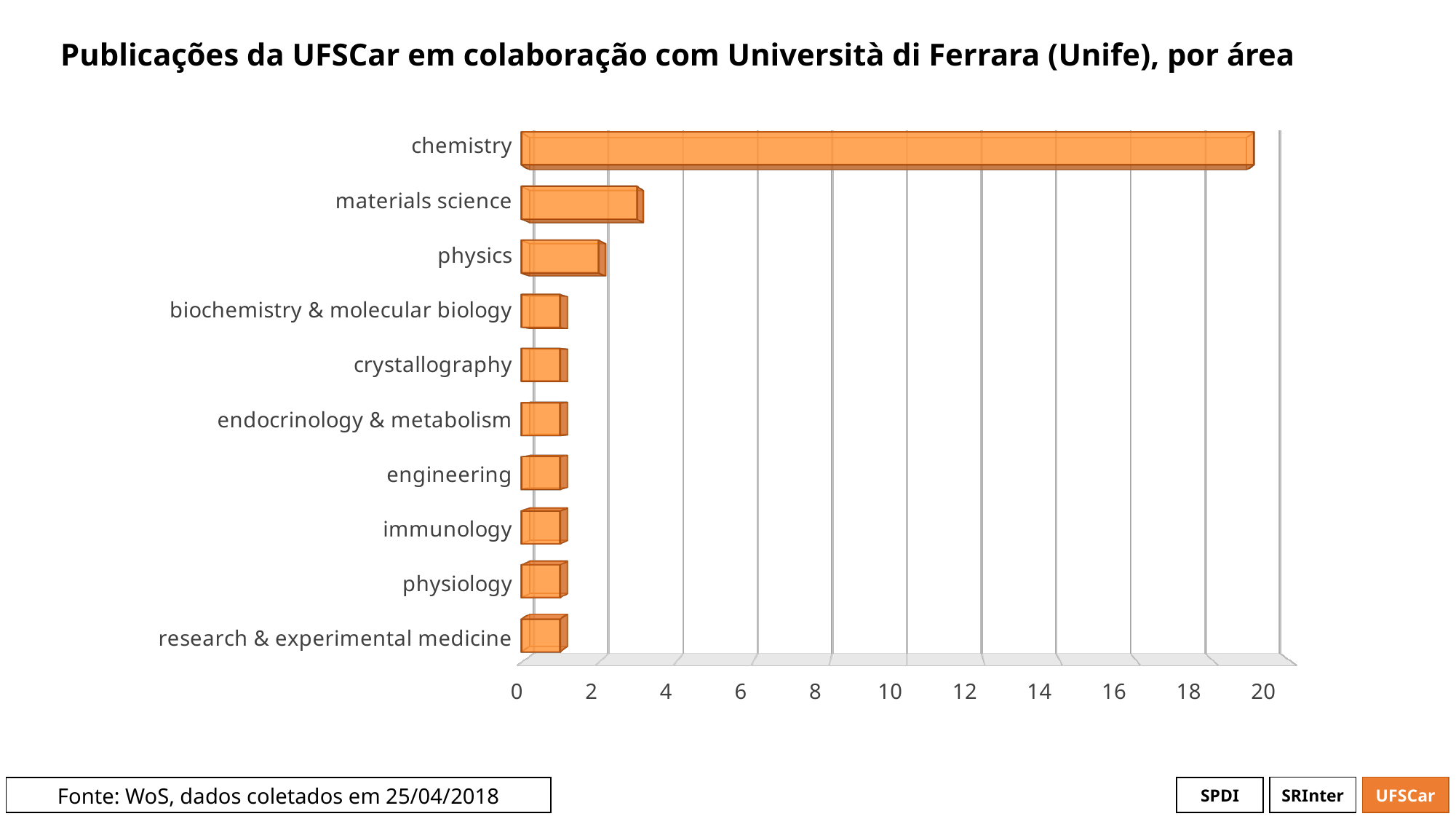
Is the value for materials science greater or less than 2? greater Is the value for chemistry greater or less than 18? greater Which has more publications, chemistry or materials science? chemistry Which area has the highest number of publications? chemistry What kind of chart is shown on the slide? bar chart What is the title of the chart? Publicações da UFSCar em colaboração com Università di Ferrara (Unife), por área Is the value for physics greater or less than 4? less Which has more publications, materials science or physics? materials science How many research areas are listed on the chart? 10